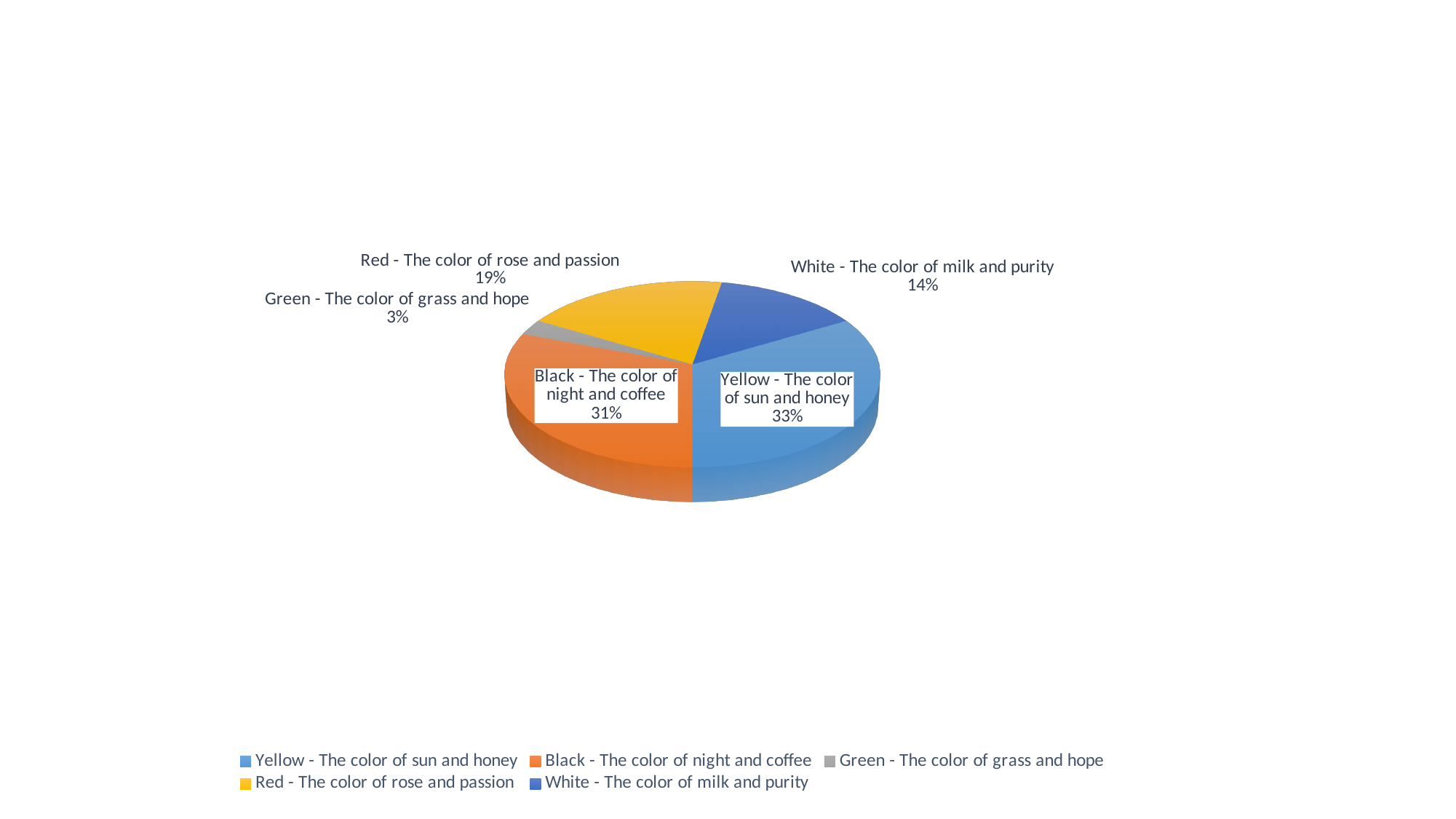
What percentage is shown for "White - The color of milk and purity"? 14% What percentage is shown for "Green - The color of grass and hope"? 3% How many slices does the pie chart have? 5 Which category has the largest share of the pie? Yellow - The color of sun and honey Which is larger, the share for Black or the share for Red? Black - The color of night and coffee Which category has the smallest share of the pie? Green - The color of grass and hope What colour is the slice for "Black - The color of night and coffee" drawn in? Orange What share of the pie does "Black - The color of night and coffee" have? 31% What kind of chart is shown on the slide? Pie chart What percentage is shown for "Red - The color of rose and passion"? 19% What is the difference in percentage points between the Red slice and the White slice? 5 What share of the pie does "Yellow - The color of sun and honey" have? 33%